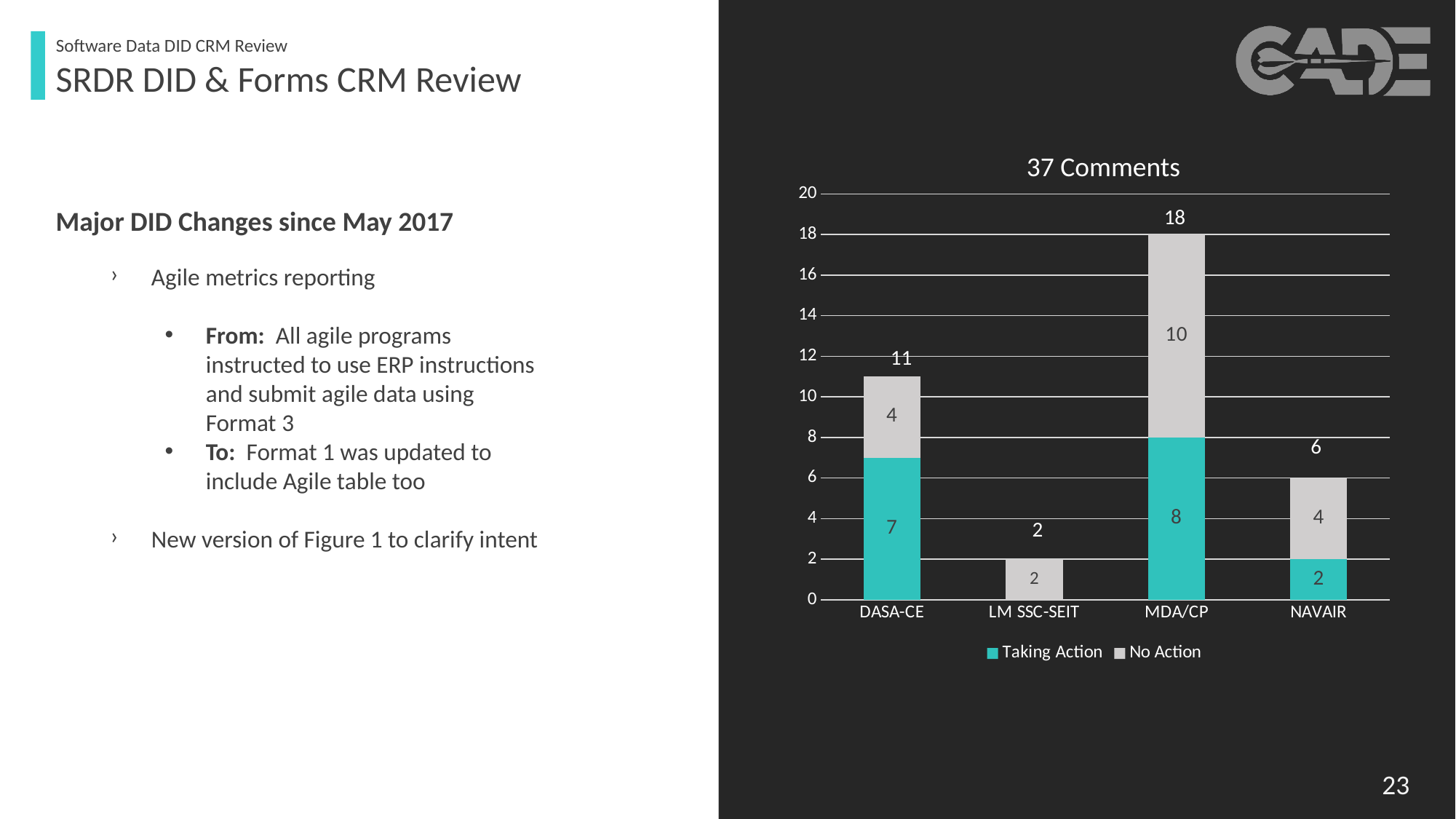
How many series does the legend list? 2 Which is larger, the Taking Action value for MDA/CP or the Taking Action value for DASA-CE? MDA/CP What is the No Action value for LM SSC-SEIT? 2 Which category has the lowest total number of comments? LM SSC-SEIT What is the total of the stacked bar for NAVAIR? 6 What is the Taking Action value for NAVAIR? 2 What is the difference between the total for MDA/CP and the total for DASA-CE? 7 What is the title of the chart? 37 Comments Which category has the highest total number of comments? MDA/CP How many categories are shown on the x axis? 4 What is the Taking Action value for DASA-CE? 7 What is the No Action value for MDA/CP? 10